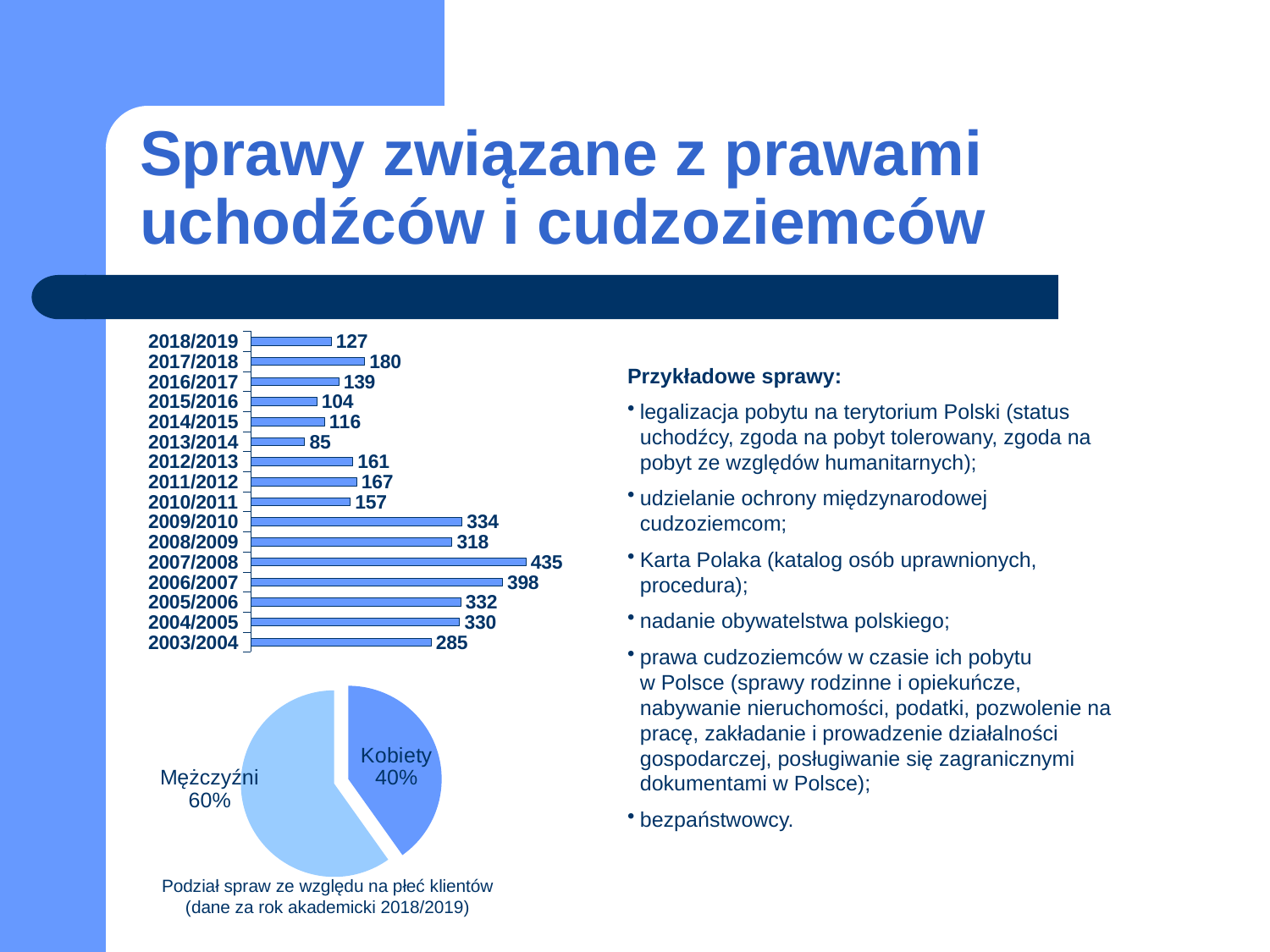
In the bar chart, what is the value for 2018/2019? 127 How many academic years are shown in the bar chart? 16 In the bar chart, what is the value for 2007/2008? 435 In the pie chart, what share is labelled Kobiety? 40% In the bar chart, which academic year has the highest value? 2007/2008 In the bar chart, which academic year has the lowest value? 2013/2014 In the bar chart, which is larger, the value for 2017/2018 or the value for 2016/2017? 2017/2018 In the bar chart, what is the value for 2013/2014? 85 In the bar chart, what is the difference between the values for 2007/2008 and 2006/2007? 37 In the pie chart, what share is labelled Mężczyźni? 60% What type of chart shows the values by academic year? Bar chart What is the caption below the pie chart? Podział spraw ze względu na płeć klientów (dane za rok akademicki 2018/2019)